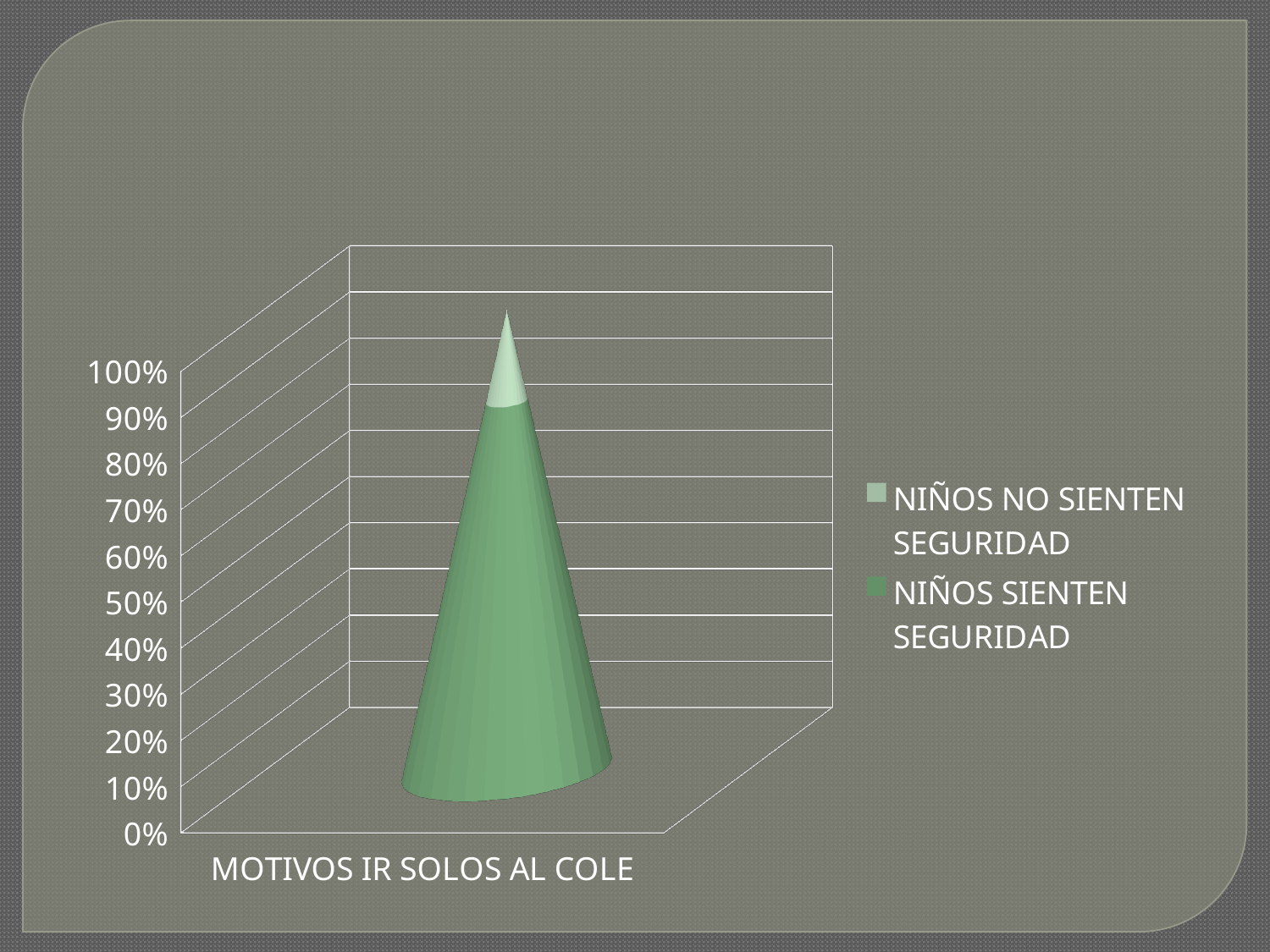
Which series takes up the larger share of the bar for MOTIVOS IR SOLOS AL COLE? NIÑOS SIENTEN SEGURIDAD What is the highest value shown on the vertical axis? 100% Which series has the largest share of the bar? NIÑOS SIENTEN SEGURIDAD What kind of chart is shown on the slide? bar chart How many categories are shown on the x axis? 1 Which series has the smallest share of the bar? NIÑOS NO SIENTEN SEGURIDAD What is the category label shown on the x axis? MOTIVOS IR SOLOS AL COLE Is the share for NIÑOS SIENTEN SEGURIDAD greater or less than 50%? greater How many series does the legend list? 2 Is the share for NIÑOS NO SIENTEN SEGURIDAD greater or less than 50%? less